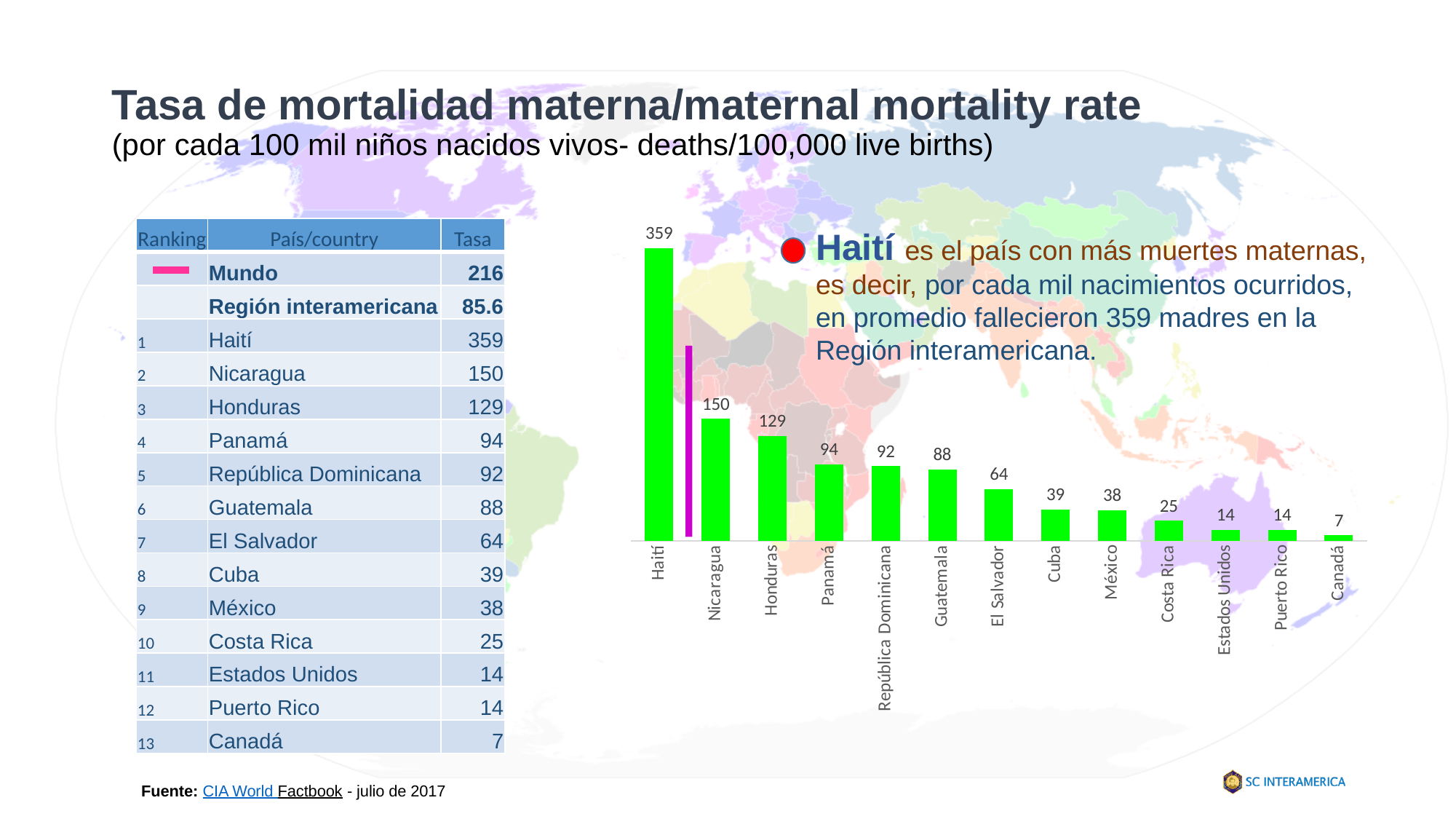
Which has a higher value in the bar chart, República Dominicana or Guatemala? República Dominicana Which country has the lowest value in the bar chart? Canadá What is the difference between the values for Haití and Nicaragua in the bar chart? 209 What type of chart is shown on the slide? Bar chart What is the maternal mortality rate shown for Nicaragua in the bar chart? 150 What value does the bar chart show for Costa Rica? 25 Do the values of the green bars rise or fall from left to right across the chart? Fall Which country has the highest value in the bar chart? Haití What is the difference between the values for Honduras and Panamá in the bar chart? 35 What value does the bar chart show for Guatemala? 88 How many countries are shown as green bars in the bar chart? 13 Which has a higher value in the bar chart, El Salvador or Cuba? El Salvador